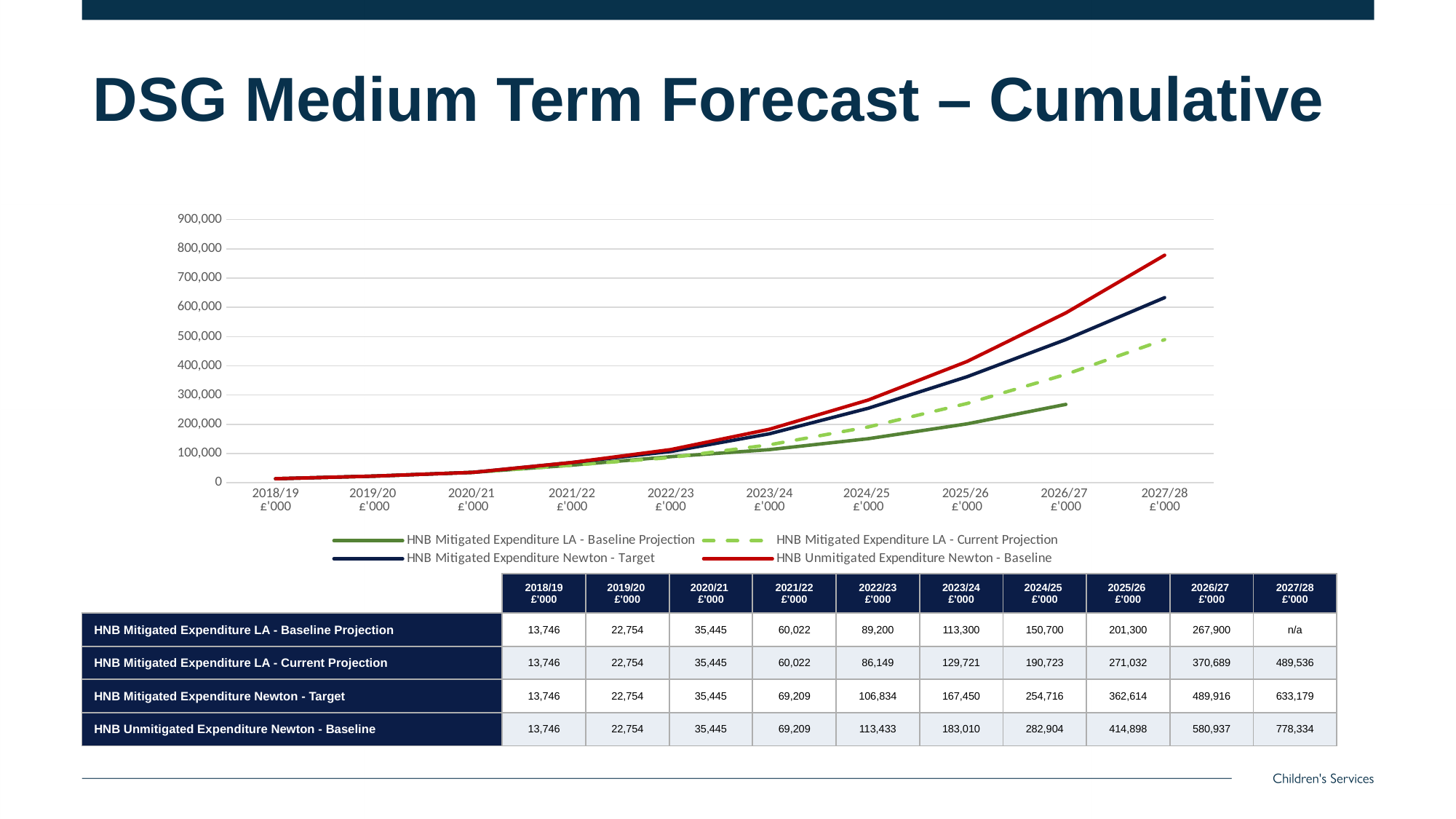
Do the values for HNB Mitigated Expenditure Newton - Target rise or fall from 2018/19 to 2027/28? rise What is the value for HNB Mitigated Expenditure LA - Current Projection in 2026/27? 370,689 What is the value for HNB Unmitigated Expenditure Newton - Baseline in 2027/28? 778,334 Which series has the lowest value in 2026/27? HNB Mitigated Expenditure LA - Baseline Projection Which series has the highest value in 2027/28? HNB Unmitigated Expenditure Newton - Baseline What is the value for HNB Mitigated Expenditure Newton - Target in 2023/24? 167,450 What is the difference between HNB Unmitigated Expenditure Newton - Baseline and HNB Mitigated Expenditure Newton - Target in 2027/28? 145,155 What kind of chart is shown on the slide? line chart How many years are plotted along the x axis? 10 In 2025/26, which is larger: HNB Mitigated Expenditure Newton - Target or HNB Mitigated Expenditure LA - Current Projection? HNB Mitigated Expenditure Newton - Target How many series does the legend list? 4 Is the value for HNB Unmitigated Expenditure Newton - Baseline in 2027/28 greater or less than 700,000? greater